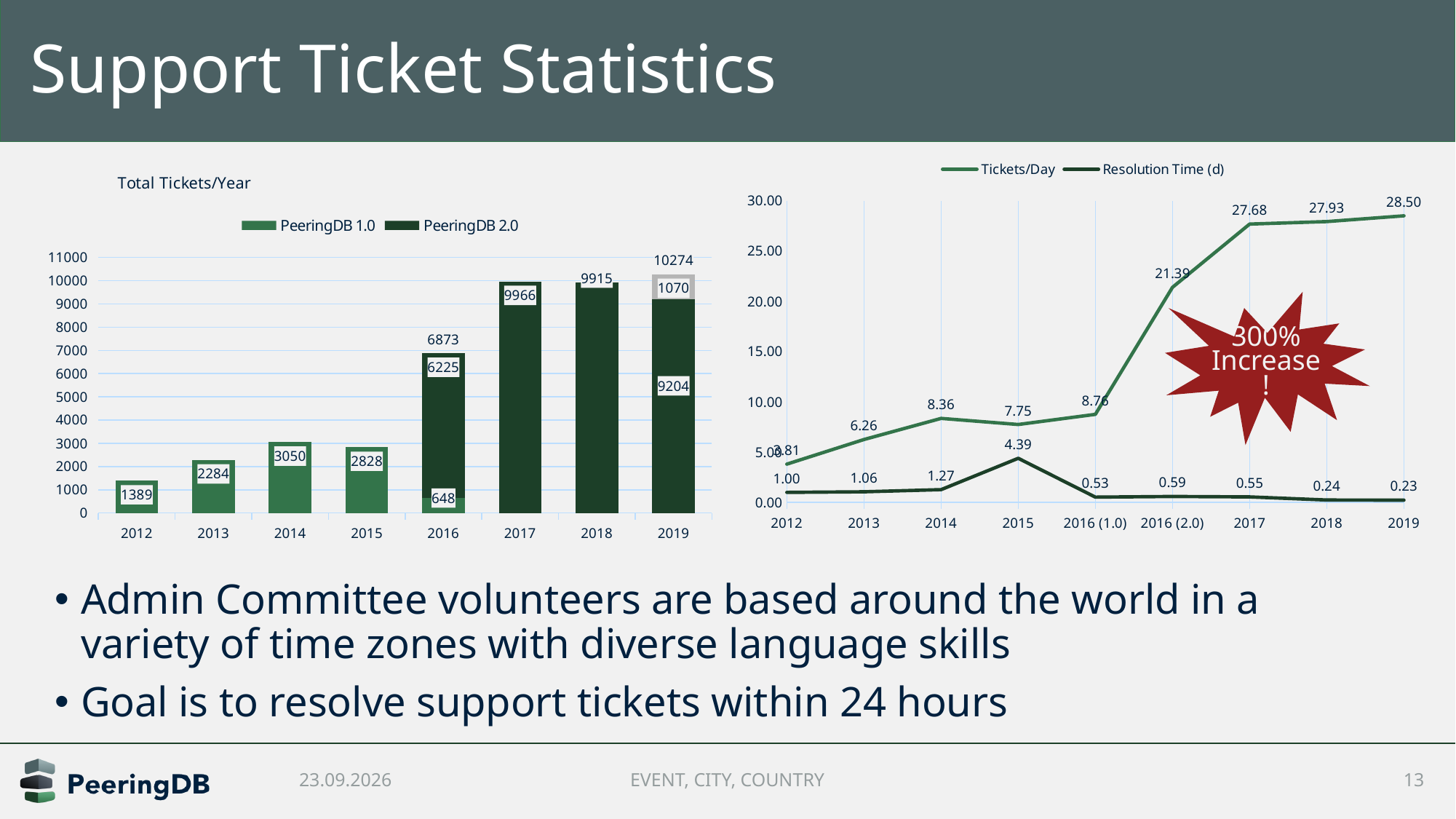
In the right-hand line chart, which is larger: Tickets/Day in 2014 or in 2015? 2014 In the Total Tickets/Year chart, how many years are shown on the x axis? 8 In the right-hand line chart, what is the difference in Tickets/Day between 2016 (2.0) and 2016 (1.0)? 12.63 In the Total Tickets/Year chart, how many total tickets were there in 2017? 9966 What kind of chart is the Total Tickets/Year chart? Bar chart In the Total Tickets/Year chart, what is the difference between the 2017 total (9966) and the 2018 total (9915)? 51 In the right-hand line chart, what is the Tickets/Day value for 2017? 27.68 In the Total Tickets/Year chart, which year has the lowest total tickets? 2012 In the Total Tickets/Year chart, what is the total height of the stacked bar for 2016? 6873 In the right-hand line chart, which year has the highest Resolution Time (d)? 2015 In the Total Tickets/Year chart, which year has the highest total tickets? 2019 In the Total Tickets/Year chart, how many series does the legend list? 2